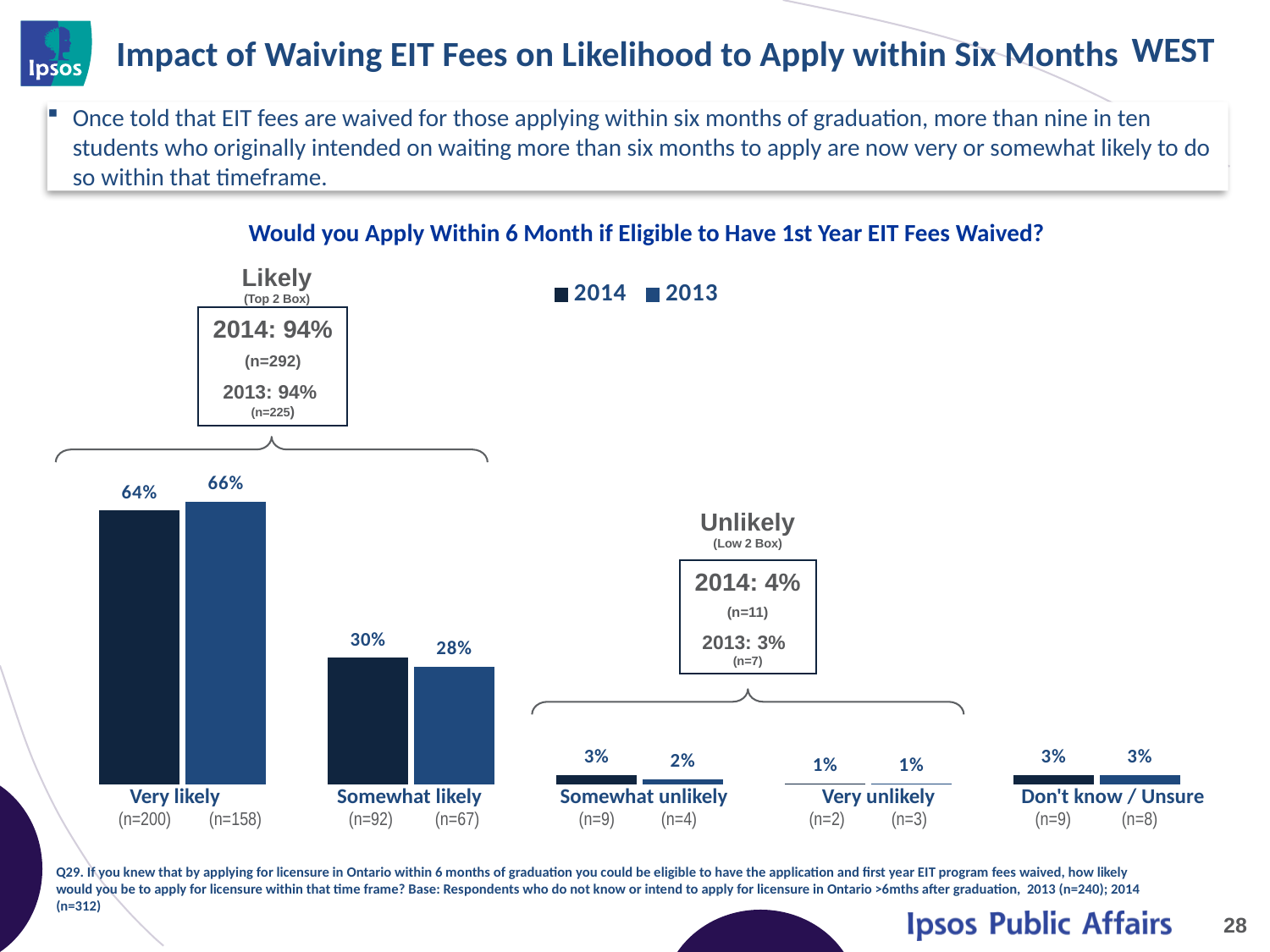
What is the title of the chart? Would you Apply Within 6 Month if Eligible to Have 1st Year EIT Fees Waived? How many response categories are shown on the x axis of the chart? 5 Which is larger for Somewhat likely: the 2014 value or the 2013 value? 2014 Which category has the highest value for the 2013 series? Very likely What is the 2014 value for Somewhat unlikely? 3% What is the Likely (Top 2 Box) percentage for 2014? 94% What type of chart is shown on the slide? Bar chart Which category has the lowest value for the 2014 series? Very unlikely What percentage of respondents in 2013 said they were somewhat likely to apply within 6 months? 28% What is the difference between the 2013 and 2014 values for Very likely? 2% What percentage of respondents in 2014 said they were very likely to apply within 6 months? 64% How many series does the chart legend list? 2